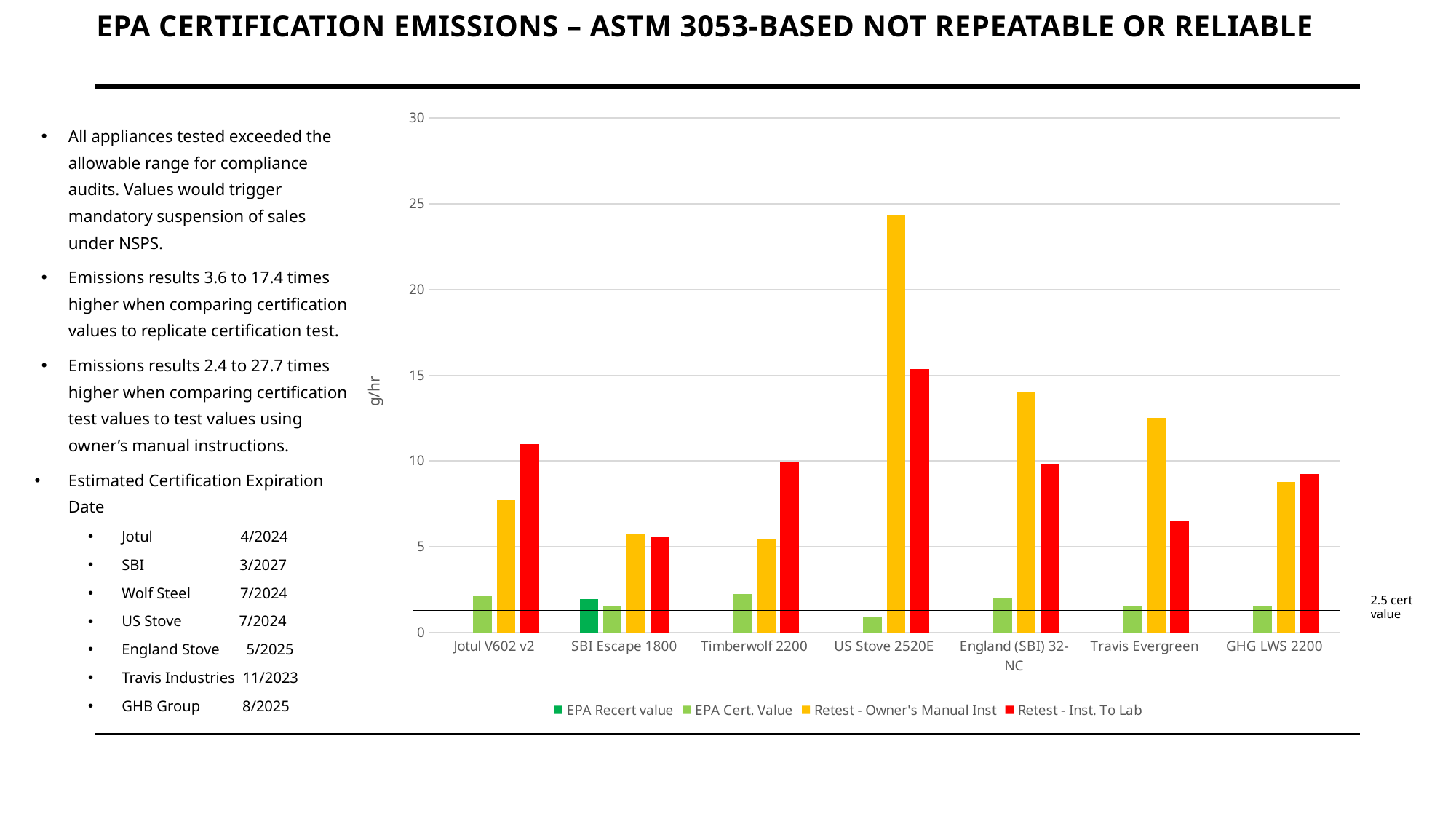
Is the Retest - Inst. To Lab value for Jotul V602 v2 greater or less than 10? greater Which appliance has the highest Retest - Inst. To Lab value? US Stove 2520E Is the Retest - Owner's Manual Inst value for England (SBI) 32-NC greater or less than 15? less For Jotul V602 v2, which is larger: the Retest - Owner's Manual Inst value or the Retest - Inst. To Lab value? Retest - Inst. To Lab Which appliance has the highest Retest - Owner's Manual Inst value? US Stove 2520E Is the Retest - Owner's Manual Inst value for US Stove 2520E greater or less than 20? greater How many appliance categories are shown on the x axis of the chart? 7 What is the label on the y axis of the chart? g/hr How many series does the chart legend list? 4 Which appliance has the lowest EPA Cert. Value? US Stove 2520E For Travis Evergreen, which is larger: the Retest - Owner's Manual Inst value or the Retest - Inst. To Lab value? Retest - Owner's Manual Inst What kind of chart is shown on the slide? bar chart